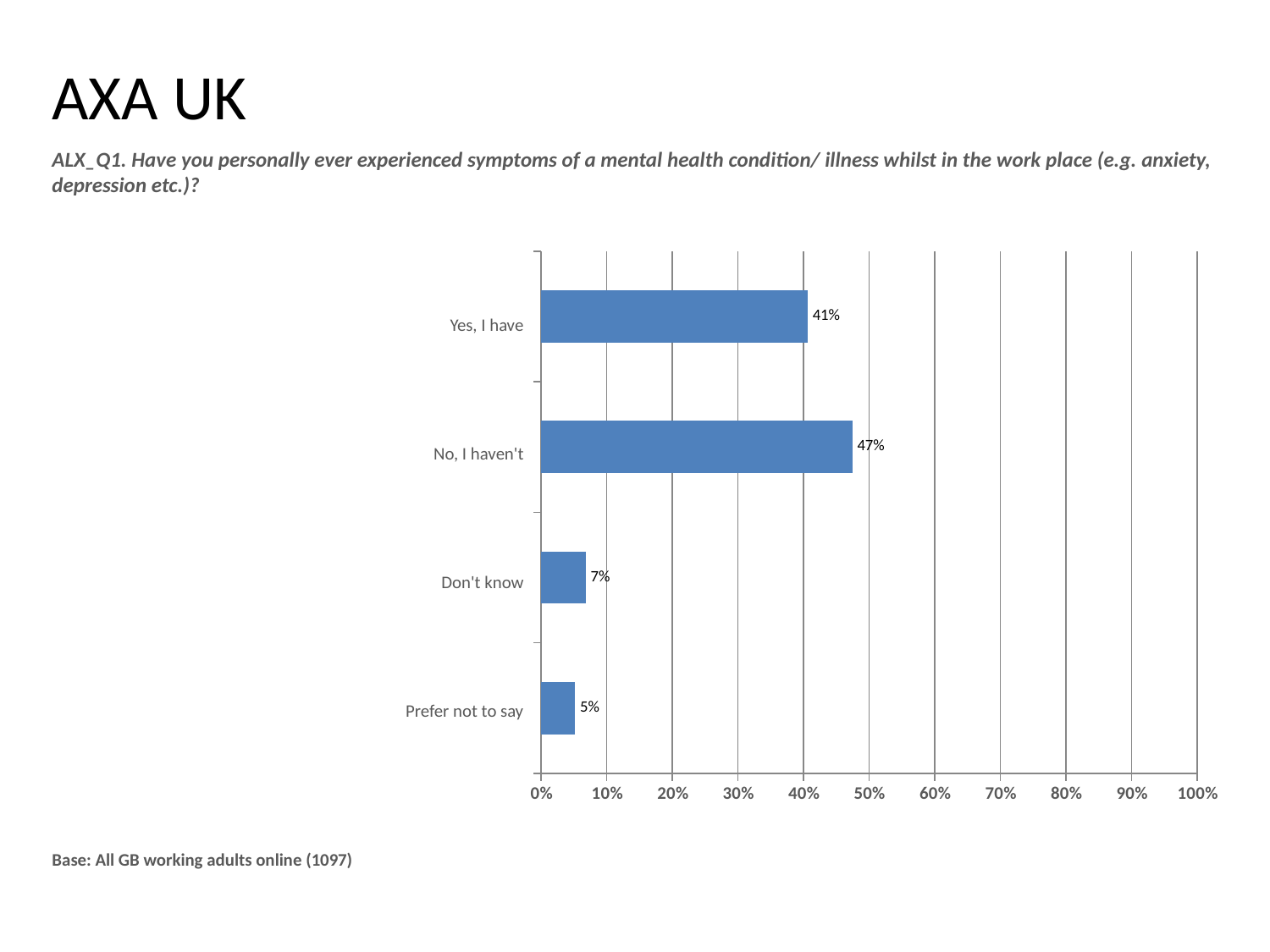
What percentage of respondents answered "Don't know"? 7% Which is larger, the value for "Don't know" or the value for "Prefer not to say"? Don't know What percentage of respondents answered "Yes, I have"? 41% What percentage of respondents answered "Prefer not to say"? 5% What is the difference in percentage points between "No, I haven't" and "Yes, I have"? 6 How many response categories are shown in the chart? 4 What percentage of respondents answered "No, I haven't"? 47% Which response category has the lowest percentage? Prefer not to say What type of chart is shown on the slide? Bar chart Is the value for "Yes, I have" greater or less than 50%? less What is the base described below the chart? All GB working adults online (1097) Which response category has the highest percentage? No, I haven't